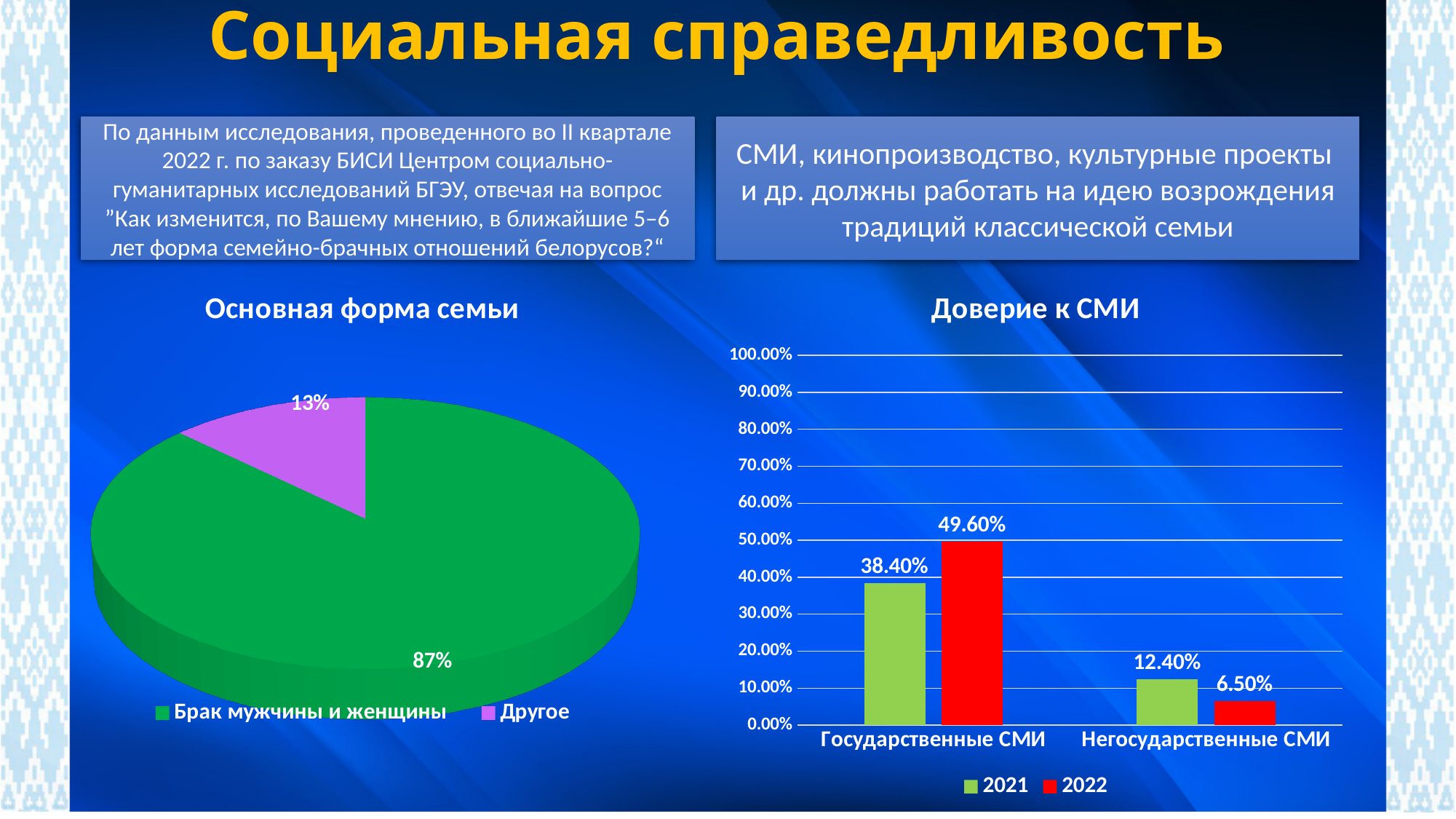
In the "Доверие к СМИ" chart, what is the 2022 value for "Государственные СМИ"? 49.60% How many slices does the "Основная форма семьи" pie chart have? 2 In the "Доверие к СМИ" chart, which is larger for "Негосударственные СМИ": the 2021 value or the 2022 value? 2021 In the "Основная форма семьи" chart, what share does "Брак мужчины и женщины" have? 87% What kind of chart is "Доверие к СМИ"? Bar chart How many series does the legend of the "Доверие к СМИ" chart list? 2 In the "Доверие к СМИ" chart, what is the difference between the 2022 and 2021 values for "Государственные СМИ"? 11.20% What kind of chart is "Основная форма семьи"? Pie chart In the "Доверие к СМИ" chart, what is the 2021 value for "Государственные СМИ"? 38.40% In the "Основная форма семьи" chart, what share does "Другое" have? 13% In the "Доверие к СМИ" chart, what is the 2022 value for "Негосударственные СМИ"? 6.50% In the "Доверие к СМИ" chart, what is the 2021 value for "Негосударственные СМИ"? 12.40%